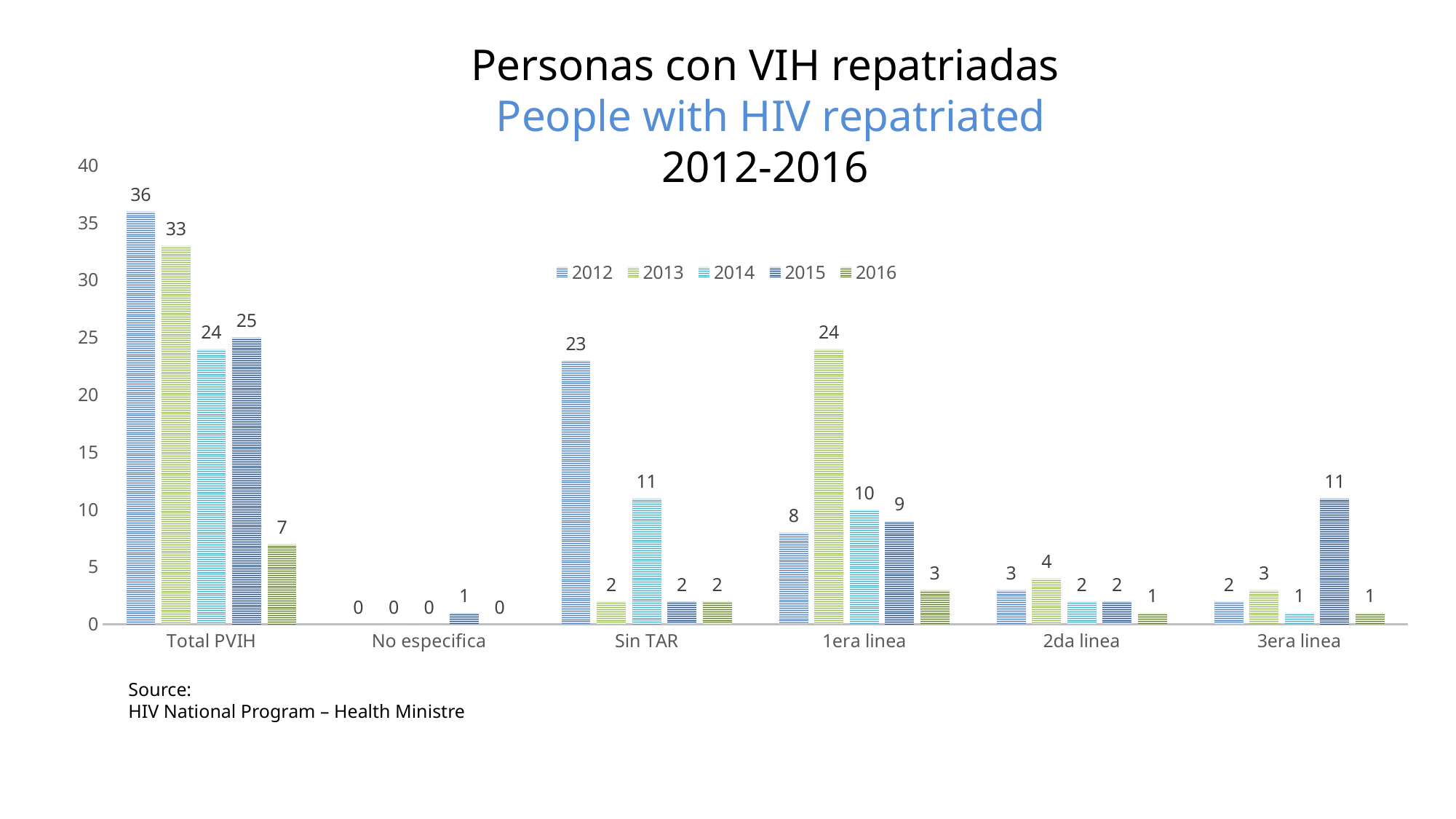
What is the difference between the 2012 and 2014 values in the Sin TAR category? 12 What is the source cited below the chart? HIV National Program – Health Ministre What is the value for 2016 in the Sin TAR category? 2 Which is larger in the 1era linea category: the 2014 value or the 2015 value? 2014 How many categories are shown on the x axis? 6 What is the value for 2013 in the 1era linea category? 24 What is the value for 2012 in the Total PVIH category? 36 What kind of chart is shown on the slide? Bar chart What is the value for 2015 in the 3era linea category? 11 Which year has the highest value in the Total PVIH category? 2012 Which year has the lowest value in the Total PVIH category? 2016 How many series does the legend list? 5